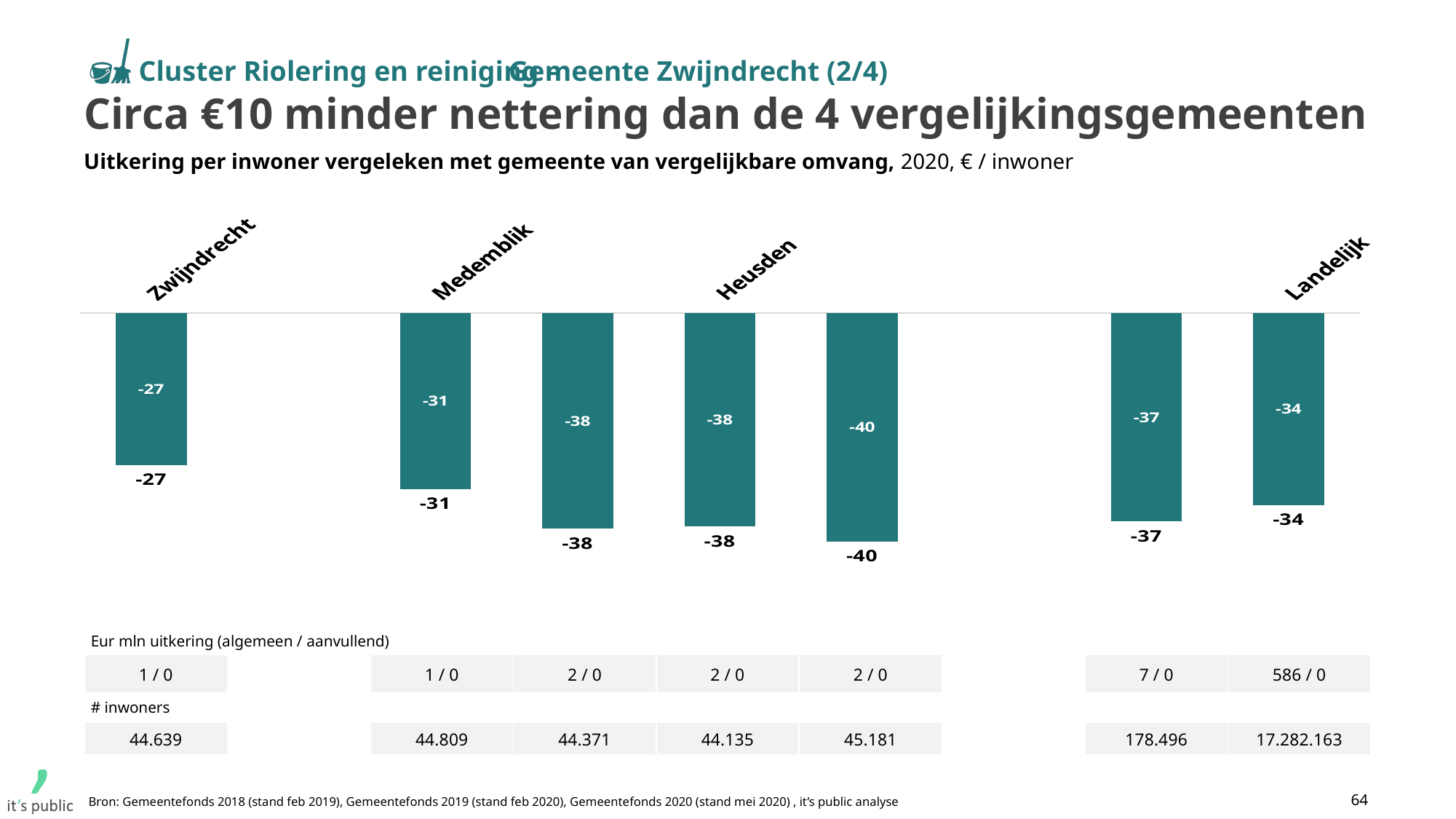
What is the difference between the values for Medemblik and Heusden? 7 What is the value for Landelijk? -34 Which is larger, the value for Zwijndrecht or the value for Medemblik? Zwijndrecht What is the value for Medemblik? -31 What is the lowest value shown on the chart? -40 Which category has the highest (least negative) value? Zwijndrecht What is the difference between the values for Zwijndrecht and Landelijk? 7 What is the value for Zwijndrecht? -27 What kind of chart is shown on the slide? Bar chart How many bars are plotted on the chart? 7 What unit is stated in the chart subtitle? € / inwoner What is the value for Heusden? -38